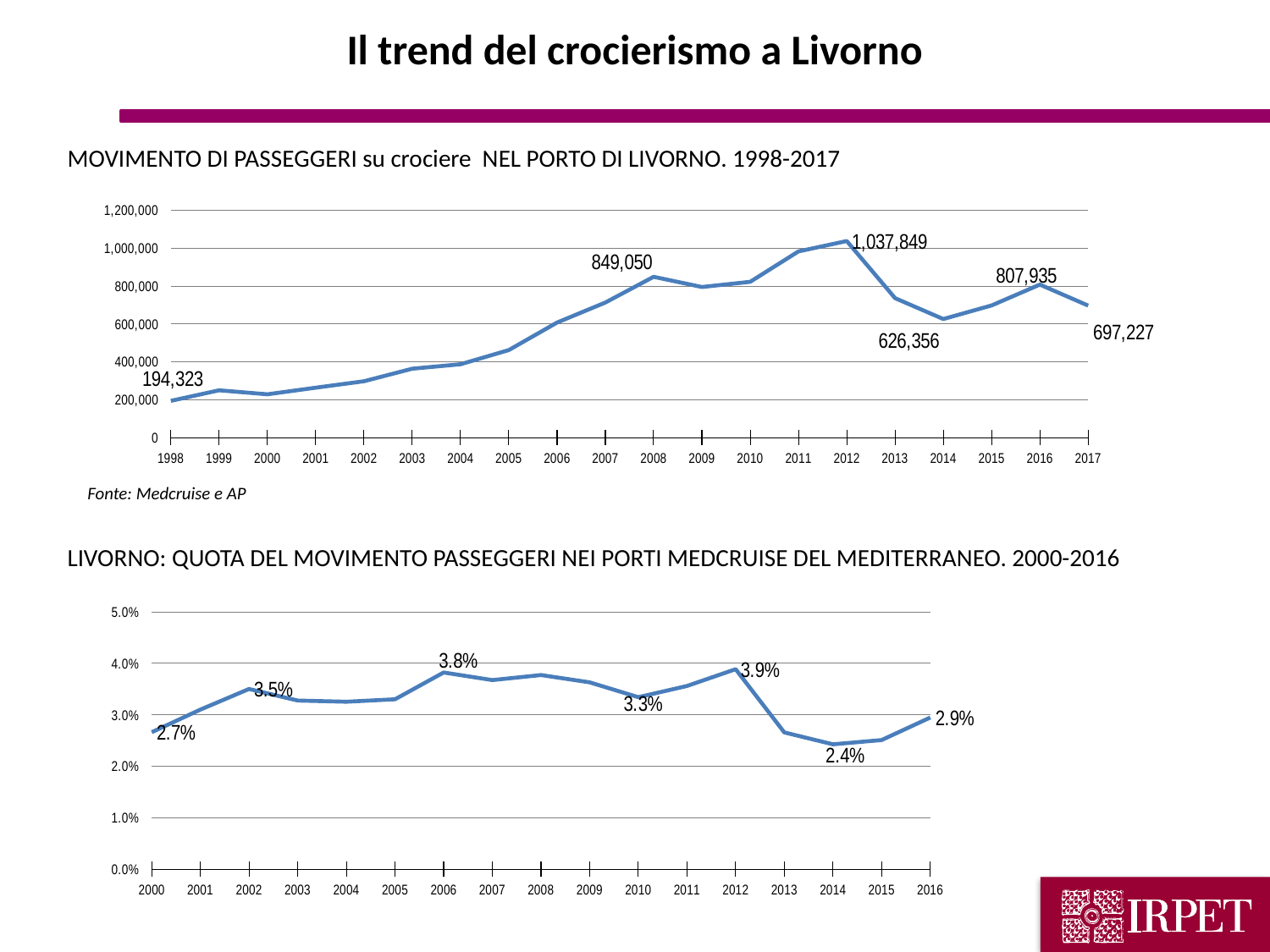
In the top chart (MOVIMENTO DI PASSEGGERI su crociere NEL PORTO DI LIVORNO), what was the passenger movement in 2017? 697,227 In the top chart (MOVIMENTO DI PASSEGGERI su crociere NEL PORTO DI LIVORNO), what was the passenger movement in 2012? 1,037,849 In the bottom chart (LIVORNO: QUOTA DEL MOVIMENTO PASSEGGERI NEI PORTI MEDCRUISE DEL MEDITERRANEO), which year has the lowest share? 2014 In the top chart (MOVIMENTO DI PASSEGGERI su crociere NEL PORTO DI LIVORNO), what was the passenger movement in 1998? 194,323 In the top chart (MOVIMENTO DI PASSEGGERI su crociere NEL PORTO DI LIVORNO), is the value for 2011 greater or less than 800,000? greater In the bottom chart (LIVORNO: QUOTA DEL MOVIMENTO PASSEGGERI NEI PORTI MEDCRUISE DEL MEDITERRANEO), what was Livorno's share in 2012? 3.9% What type of chart is the top chart (MOVIMENTO DI PASSEGGERI su crociere NEL PORTO DI LIVORNO)? Line chart In the top chart (MOVIMENTO DI PASSEGGERI su crociere NEL PORTO DI LIVORNO), which year has the highest passenger movement? 2012 In the top chart (MOVIMENTO DI PASSEGGERI su crociere NEL PORTO DI LIVORNO), how many years are shown on the x axis? 20 In the top chart (MOVIMENTO DI PASSEGGERI su crociere NEL PORTO DI LIVORNO), what is the difference between the 2016 value and the 2017 value? 110,708 In the bottom chart (LIVORNO: QUOTA DEL MOVIMENTO PASSEGGERI NEI PORTI MEDCRUISE DEL MEDITERRANEO), does the share rise or fall from 2012 to 2014? Fall In the bottom chart (LIVORNO: QUOTA DEL MOVIMENTO PASSEGGERI NEI PORTI MEDCRUISE DEL MEDITERRANEO), which is larger, the share in 2006 or the share in 2010? 2006